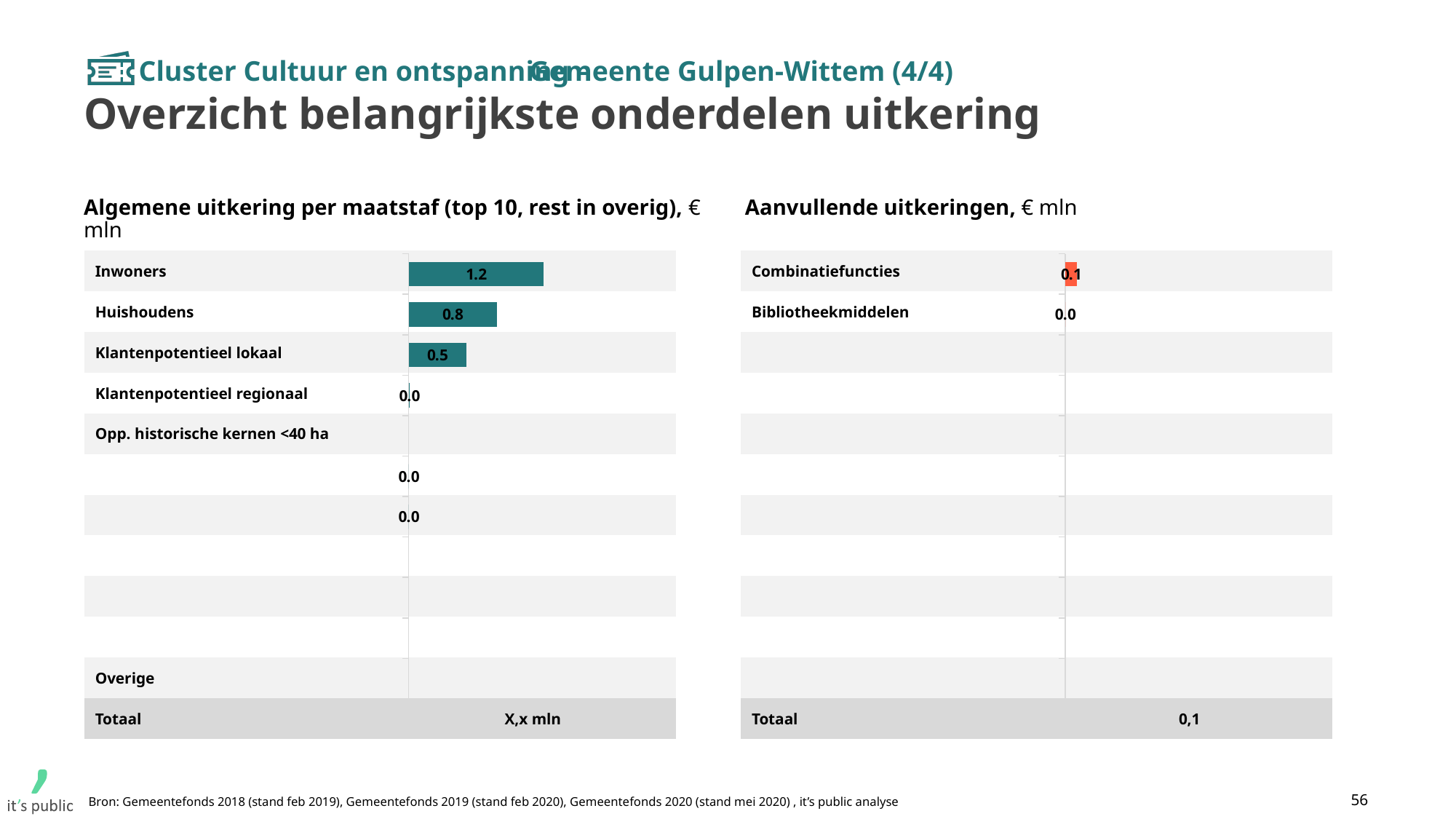
In the 'Algemene uitkering per maatstaf' chart, what is the value for Klantenpotentieel regionaal? 0.0 In the 'Aanvullende uitkeringen' chart, what is the value for Combinatiefuncties? 0.1 In the 'Algemene uitkering per maatstaf' chart, what is the value for Klantenpotentieel lokaal? 0.5 What type of chart is the 'Algemene uitkering per maatstaf' chart? Bar chart In the 'Algemene uitkering per maatstaf' chart, what is the value for Huishoudens? 0.8 In the 'Aanvullende uitkeringen' chart, what is the value for Bibliotheekmiddelen? 0.0 In the 'Algemene uitkering per maatstaf' chart, which labelled category has the highest value? Inwoners In the 'Algemene uitkering per maatstaf' chart, what is the value for Inwoners? 1.2 In the 'Algemene uitkering per maatstaf' chart, what is the difference between Inwoners and Huishoudens? 0.4 In the 'Algemene uitkering per maatstaf' chart, which is larger: Huishoudens or Klantenpotentieel lokaal? Huishoudens What total is shown in the 'Totaal' row of the 'Aanvullende uitkeringen' chart? 0,1 In the 'Aanvullende uitkeringen' chart, which category has the higher value: Combinatiefuncties or Bibliotheekmiddelen? Combinatiefuncties